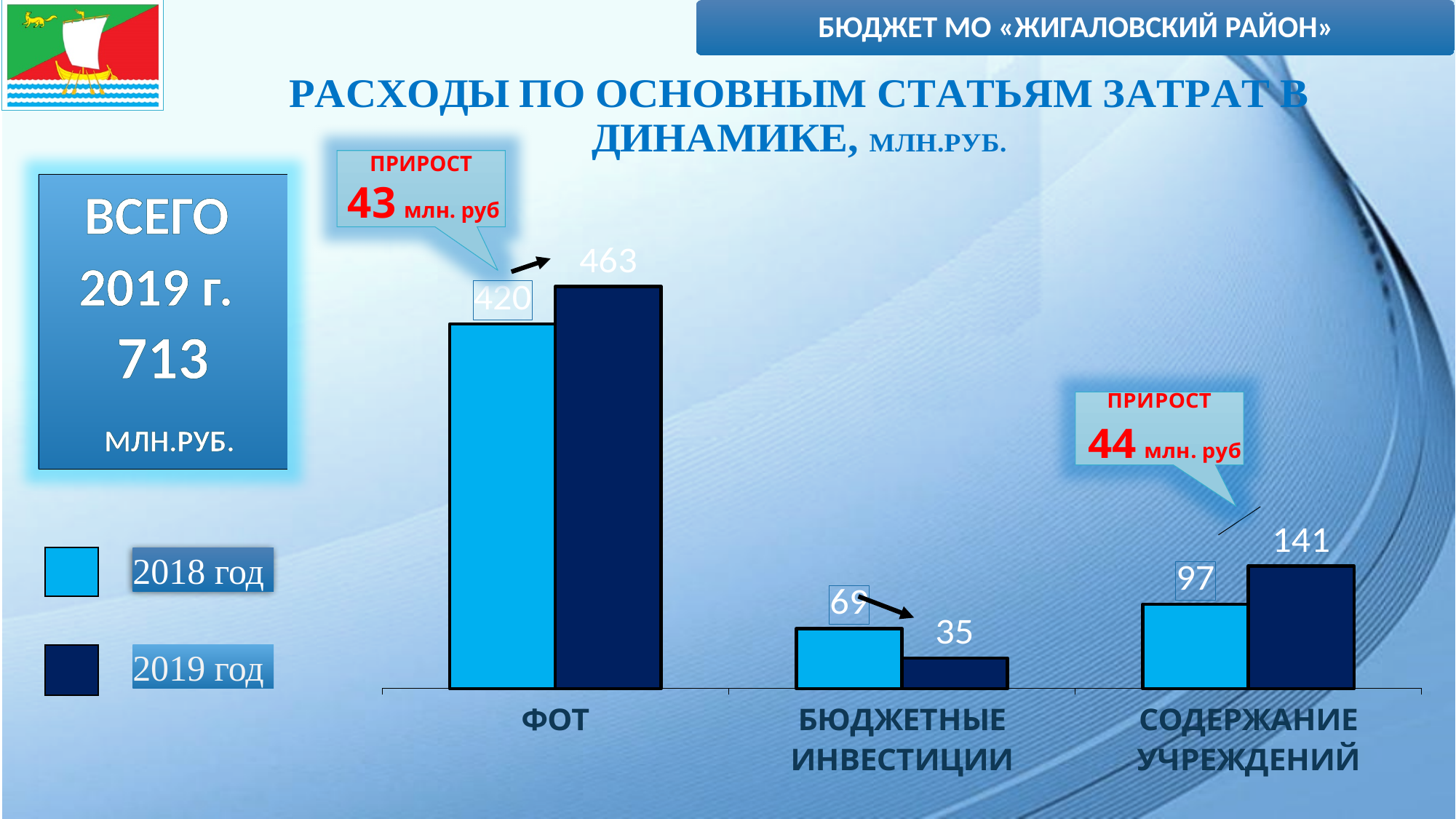
Which category has the lowest value for 2019 год? БЮДЖЕТНЫЕ ИНВЕСТИЦИИ What is the value for СОДЕРЖАНИЕ УЧРЕЖДЕНИЙ in 2018 год? 97 What is the value for ФОТ in 2018 год? 420 What is the value for ФОТ in 2019 год? 463 How many series does the legend list? 2 By how much did the value for ФОТ increase from 2018 год to 2019 год? 43 What is the value for БЮДЖЕТНЫЕ ИНВЕСТИЦИИ in 2019 год? 35 How many categories are shown on the x axis of the chart? 3 Which is larger for БЮДЖЕТНЫЕ ИНВЕСТИЦИИ: the 2018 год value or the 2019 год value? 2018 год Which category has the highest value for 2019 год? ФОТ What kind of chart is shown on the slide? bar chart What is the value for СОДЕРЖАНИЕ УЧРЕЖДЕНИЙ in 2019 год? 141